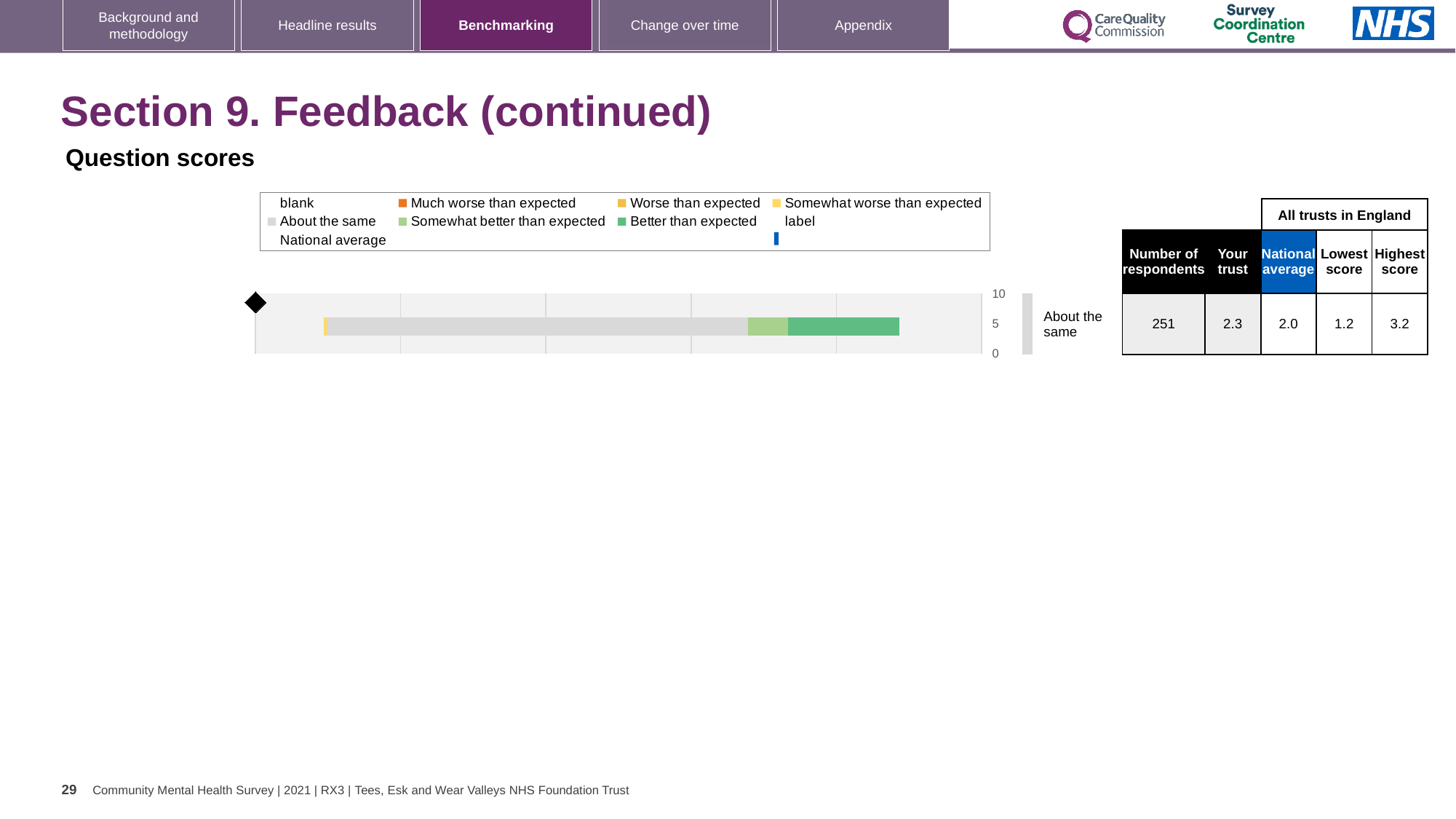
How many bars (categories) are plotted in the chart? 1 In the table next to the chart, what is the highest score among all trusts in England? 3.2 What is the category label shown next to the bar in the chart? About the same What is the highest value shown on the chart's axis? 10 In the table next to the chart, what is the national average score for 'About the same'? 2.0 In the table next to the chart, what is the lowest score among all trusts in England? 1.2 Which colour in the legend represents 'Better than expected'? Green What kind of chart is shown on the slide? Bar chart What is the difference between the highest score and the lowest score shown in the table? 2.0 Which is larger for 'About the same': the 'Your trust' score or the national average? Your trust In the table next to the chart, what is the 'Your trust' score for 'About the same'? 2.3 In the table next to the chart, what is the number of respondents for 'About the same'? 251